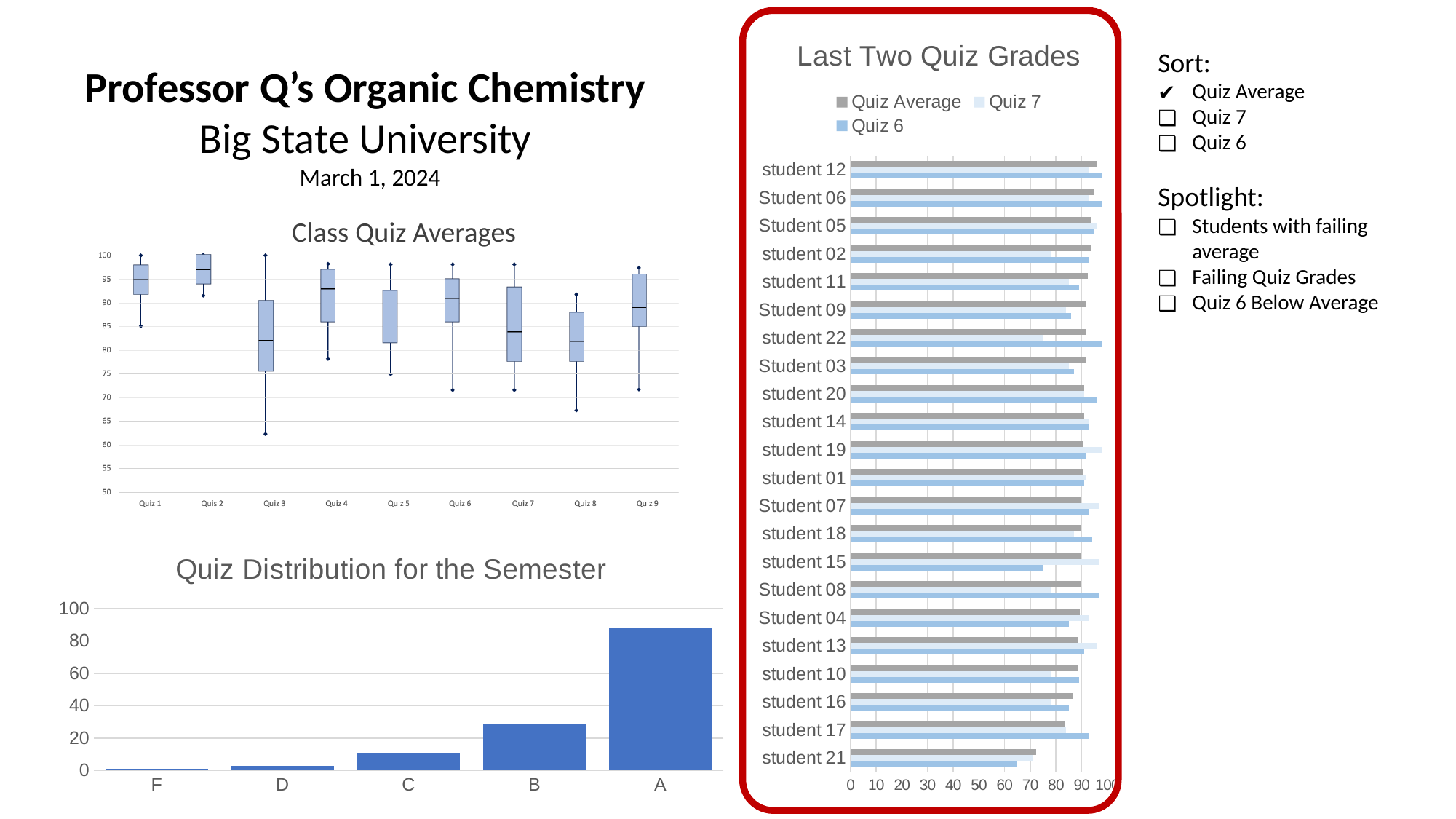
What kind of chart is the Quiz Distribution for the Semester chart? bar chart In the Class Quiz Averages chart, which quiz has the lowest minimum score? Quiz 3 In the Quiz Distribution for the Semester chart, which grade category has the highest value? A In the Quiz Distribution for the Semester chart, is the value for A greater or less than 80? greater How many students are shown in the Last Two Quiz Grades chart? 22 How many quizzes are shown in the Class Quiz Averages chart? 9 In the Last Two Quiz Grades chart, which student has the lowest Quiz Average? student 21 In the Quiz Distribution for the Semester chart, is the value for B greater or less than 40? less In the Last Two Quiz Grades chart, is the Quiz 6 value for student 21 greater or less than 70? less In the Quiz Distribution for the Semester chart, which grade category has the lowest value? F How many grade categories are shown in the Quiz Distribution for the Semester chart? 5 How many series does the legend of the Last Two Quiz Grades chart list? 3